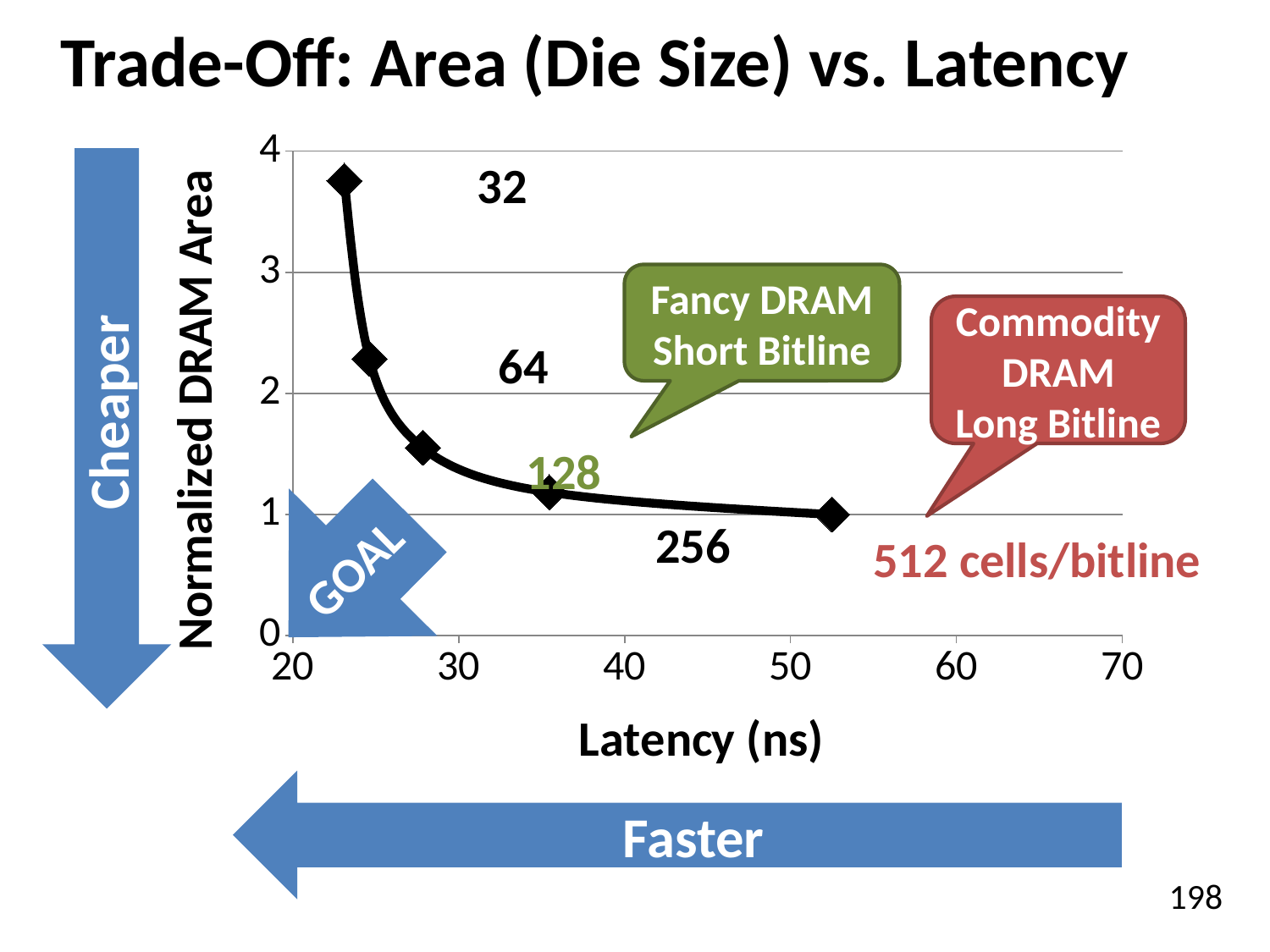
Which cells/bitline configuration has the lowest normalized DRAM area? 512 cells/bitline What is the title of the chart on the slide? Trade-Off: Area (Die Size) vs. Latency Is the normalized DRAM area for the 32 cells/bitline point greater or less than 3? greater Which cells/bitline configuration has the highest latency? 512 cells/bitline How many data points are plotted on the curve? 5 Is the normalized DRAM area for the 128 cells/bitline point greater or less than 2? less Which cells/bitline configuration has the highest normalized DRAM area? 32 What kind of chart is shown on the slide? line chart Is the latency for the 512 cells/bitline point greater or less than 50 ns? greater What is the label of the x axis? Latency (ns) Which has a larger normalized DRAM area, the 64 cells/bitline point or the 256 cells/bitline point? 64 As latency increases along the x axis, does the normalized DRAM area rise or fall? fall